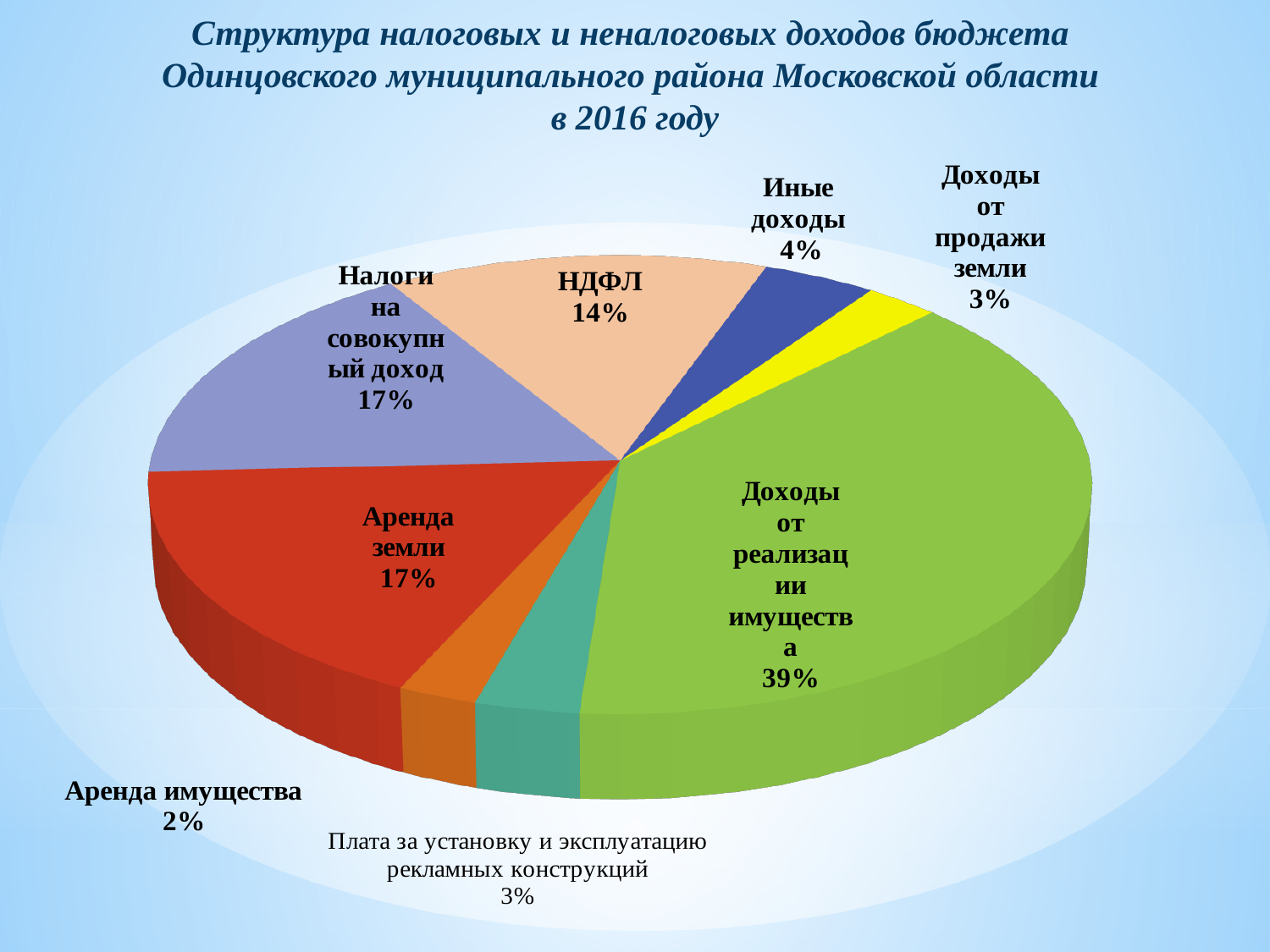
How many slices does the pie chart have? 8 What is the value shown for "Аренда земли"? 17% What is the value shown for "Иные доходы"? 4% What is the difference between the shares of "Доходы от реализации имущества" and "Налоги на совокупный доход"? 22% Which category has the largest share of the pie? Доходы от реализации имущества What share of the pie does "Доходы от реализации имущества" have? 39% What year does the chart title refer to? 2016 What type of chart is shown on the slide? Pie chart What is the value shown for "НДФЛ"? 14% Which is larger: the share of "НДФЛ" or the share of "Иные доходы"? НДФЛ What is the value shown for "Плата за установку и эксплуатацию рекламных конструкций"? 3% Which category has the smallest share of the pie? Аренда имущества